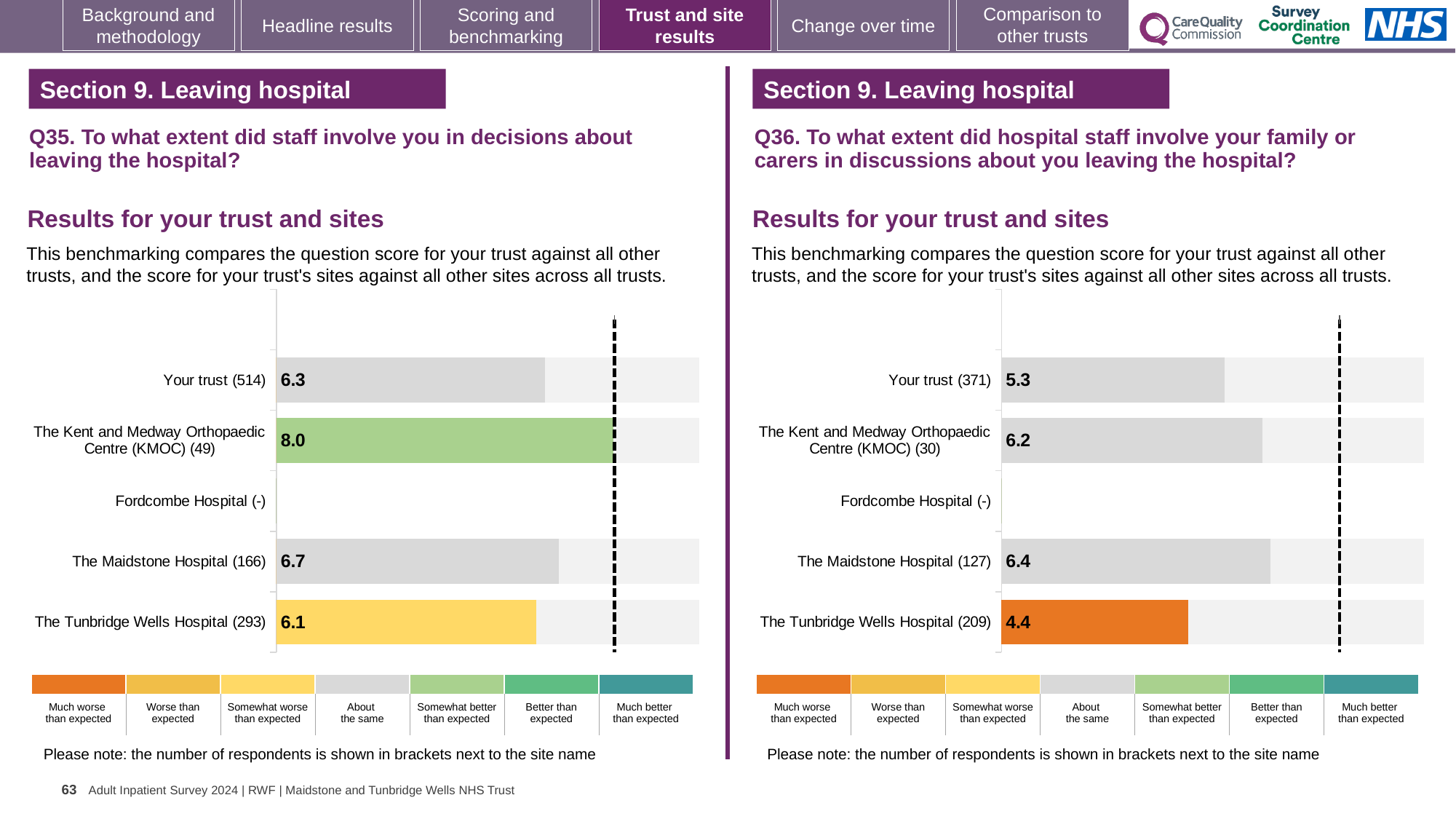
In the Q35 chart on the left, which site has the highest score? The Kent and Medway Orthopaedic Centre (KMOC) What kind of chart is used for the Q35 results on the left? Bar chart How many trust/site rows are listed in the Q36 chart on the right? 5 In the Q35 chart on the left, what is the difference between the scores for The Maidstone Hospital and The Tunbridge Wells Hospital? 0.6 In the Q36 chart on the right, which is larger: the score for Your trust or the score for The Kent and Medway Orthopaedic Centre (KMOC)? The Kent and Medway Orthopaedic Centre (KMOC) In the Q36 chart on the right, what is the score for The Maidstone Hospital (127)? 6.4 In the Q35 chart on the left, what is the score for Your trust (514)? 6.3 In the Q35 chart on the left, what colour is the bar for The Tunbridge Wells Hospital (293)? Yellow In the Q36 chart on the right, which site has the lowest score? The Tunbridge Wells Hospital In the Q36 chart on the right, what is the score for The Tunbridge Wells Hospital (209)? 4.4 In the Q35 chart on the left, what is the score for The Kent and Medway Orthopaedic Centre (KMOC) (49)? 8.0 In the Q36 chart on the right, what is the difference between the scores for The Kent and Medway Orthopaedic Centre (KMOC) and Your trust? 0.9